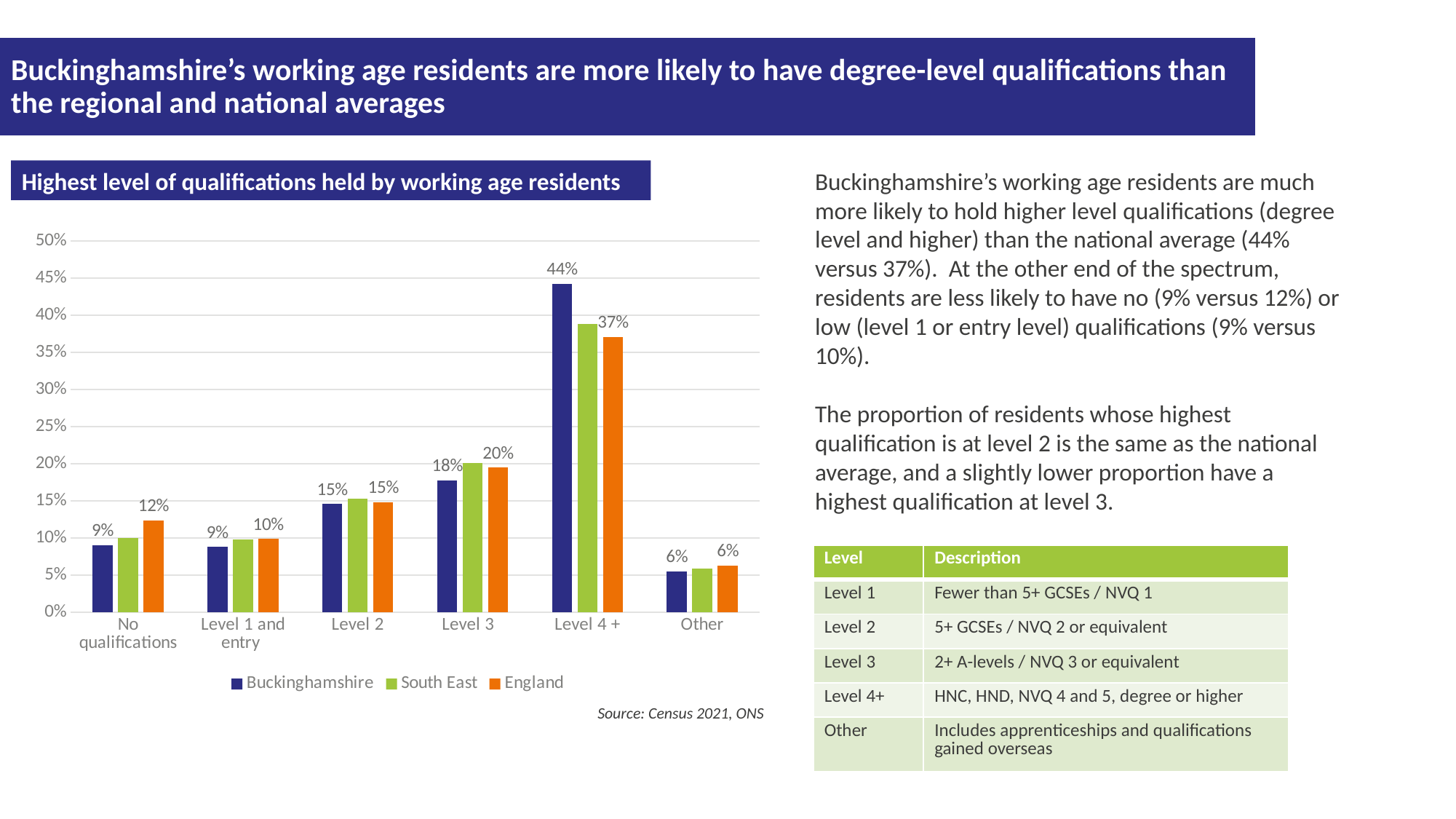
What is the difference between the Buckinghamshire and England values for Level 4 +? 7 percentage points What is the title of the chart? Highest level of qualifications held by working age residents What is the value for England in the Level 3 category? 20% Which qualification category has the highest value for Buckinghamshire? Level 4 + What is the value for England in the 'No qualifications' category? 12% Which qualification category has the lowest value for England? Other How many series does the legend list? 3 In the 'No qualifications' category, which is larger: Buckinghamshire or England? England How many qualification categories are shown on the x axis? 6 What kind of chart is shown on the slide? bar chart What percentage of Buckinghamshire's working age residents have Level 4 + qualifications? 44% Is the South East value for Level 4 + greater or less than 35%? greater